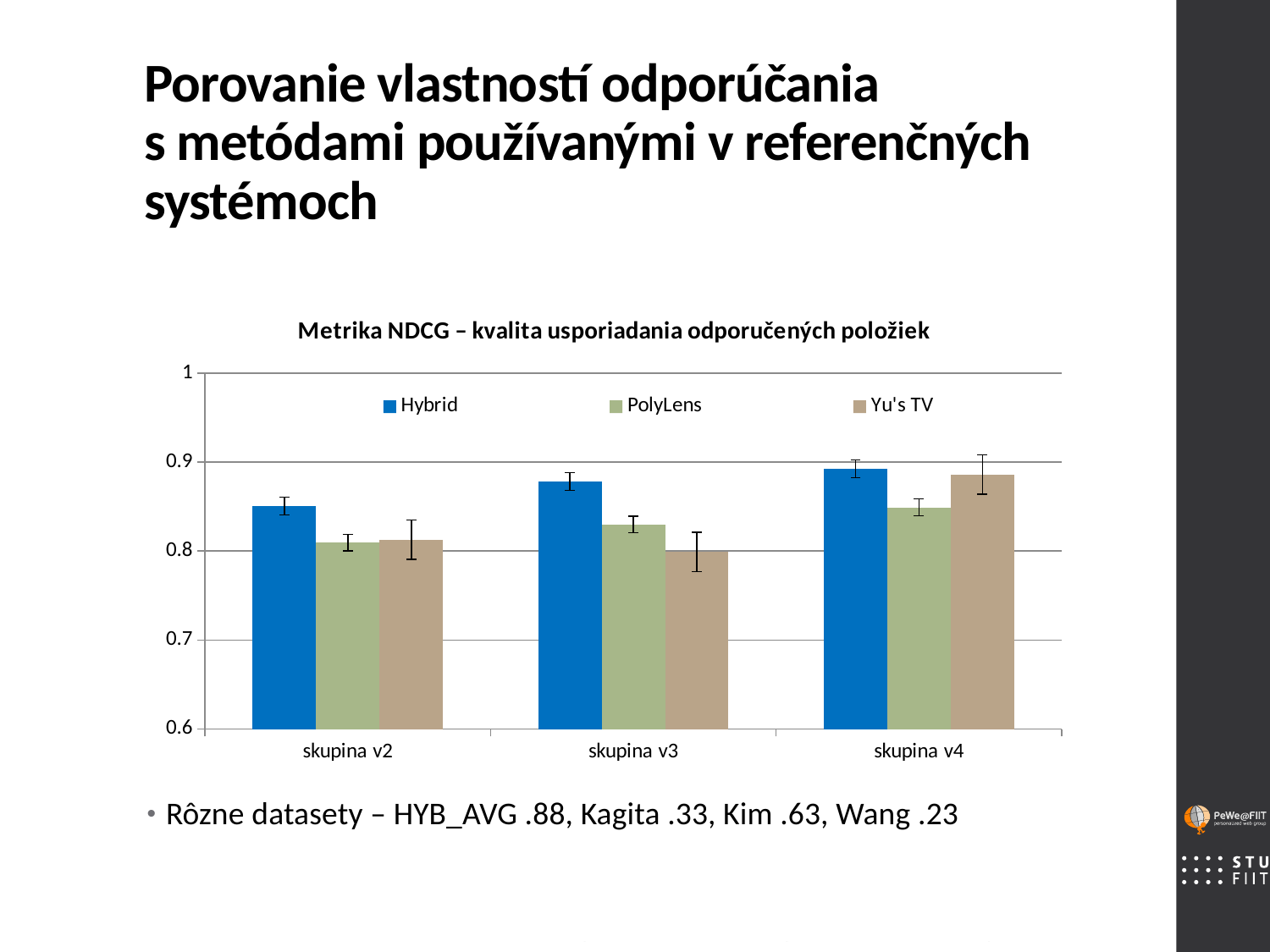
Is the value for PolyLens in skupina v3 greater or less than 0.9? less Which series has the highest value in skupina v3? Hybrid Do the Hybrid values rise or fall from skupina v2 to skupina v4? rise Which series has the lowest value in skupina v4? PolyLens What kind of chart is shown on the slide? bar chart Is the value for Hybrid in skupina v2 greater or less than 0.8? greater How many series does the legend list? 3 Which series is shown in blue in the legend? Hybrid Is the value for Yu's TV in skupina v4 greater or less than 0.8? greater How many groups (categories) are shown on the x axis? 3 What is the title of the chart? Metrika NDCG – kvalita usporiadania odporučených položiek